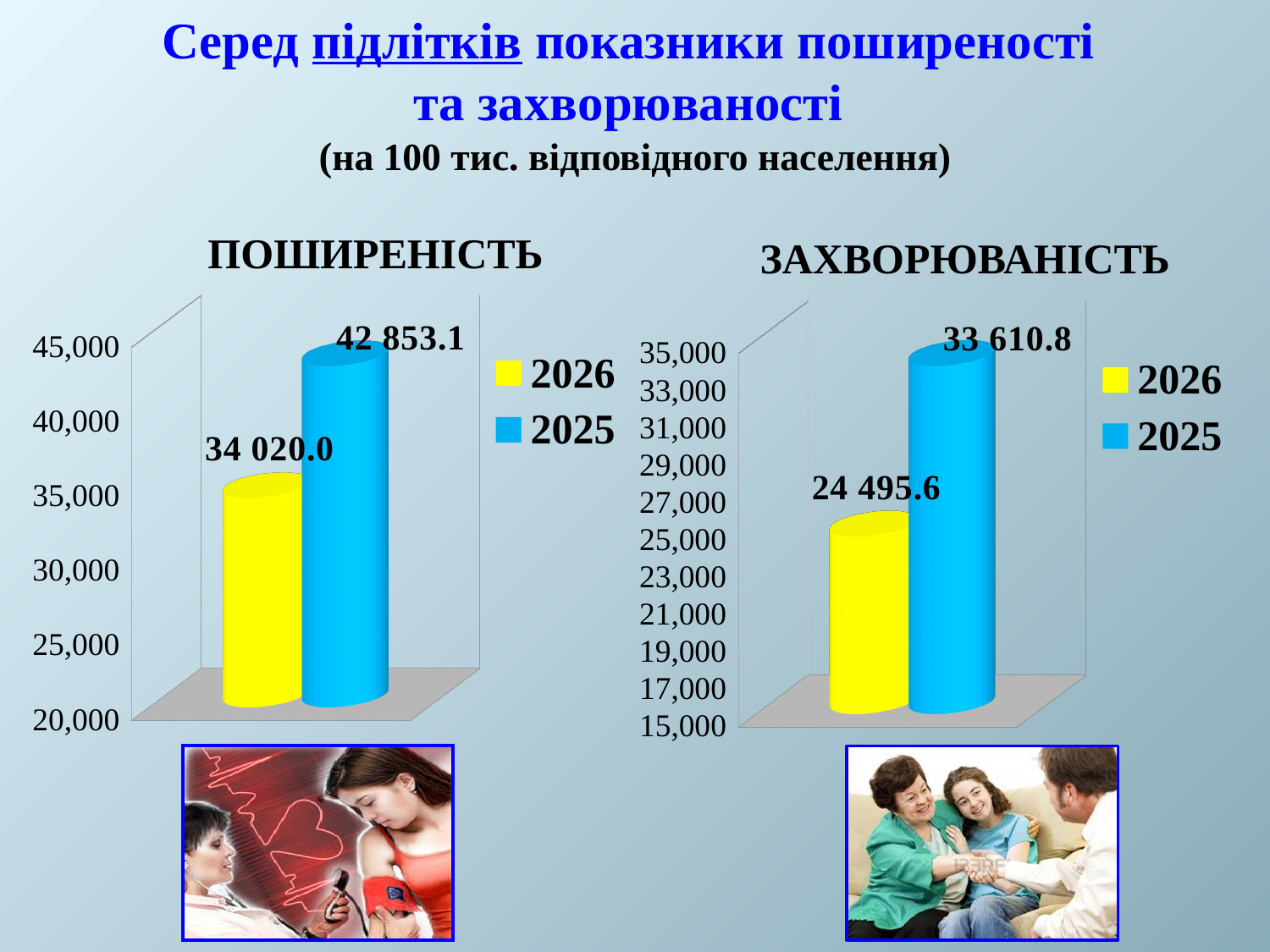
In the ЗАХВОРЮВАНІСТЬ chart, what is the difference between the 2025 and 2026 values? 9 115.2 What kind of chart is the ЗАХВОРЮВАНІСТЬ chart? bar chart In the ПОШИРЕНІСТЬ chart, what is the value for 2025? 42 853.1 In the ЗАХВОРЮВАНІСТЬ chart, what is the value for 2025? 33 610.8 In the ЗАХВОРЮВАНІСТЬ chart, which year has the lower value? 2026 How many series does the legend of the ПОШИРЕНІСТЬ chart list? 2 In the ПОШИРЕНІСТЬ chart, what is the difference between the 2025 and 2026 values? 8 833.1 In the ЗАХВОРЮВАНІСТЬ chart, is the value for 2025 larger or smaller than the value for 2026? larger In the ПОШИРЕНІСТЬ chart, what is the value for 2026? 34 020.0 In the ЗАХВОРЮВАНІСТЬ chart, what is the value for 2026? 24 495.6 In the ПОШИРЕНІСТЬ chart, what colour represents 2026? yellow In the ПОШИРЕНІСТЬ chart, which year has the higher value? 2025